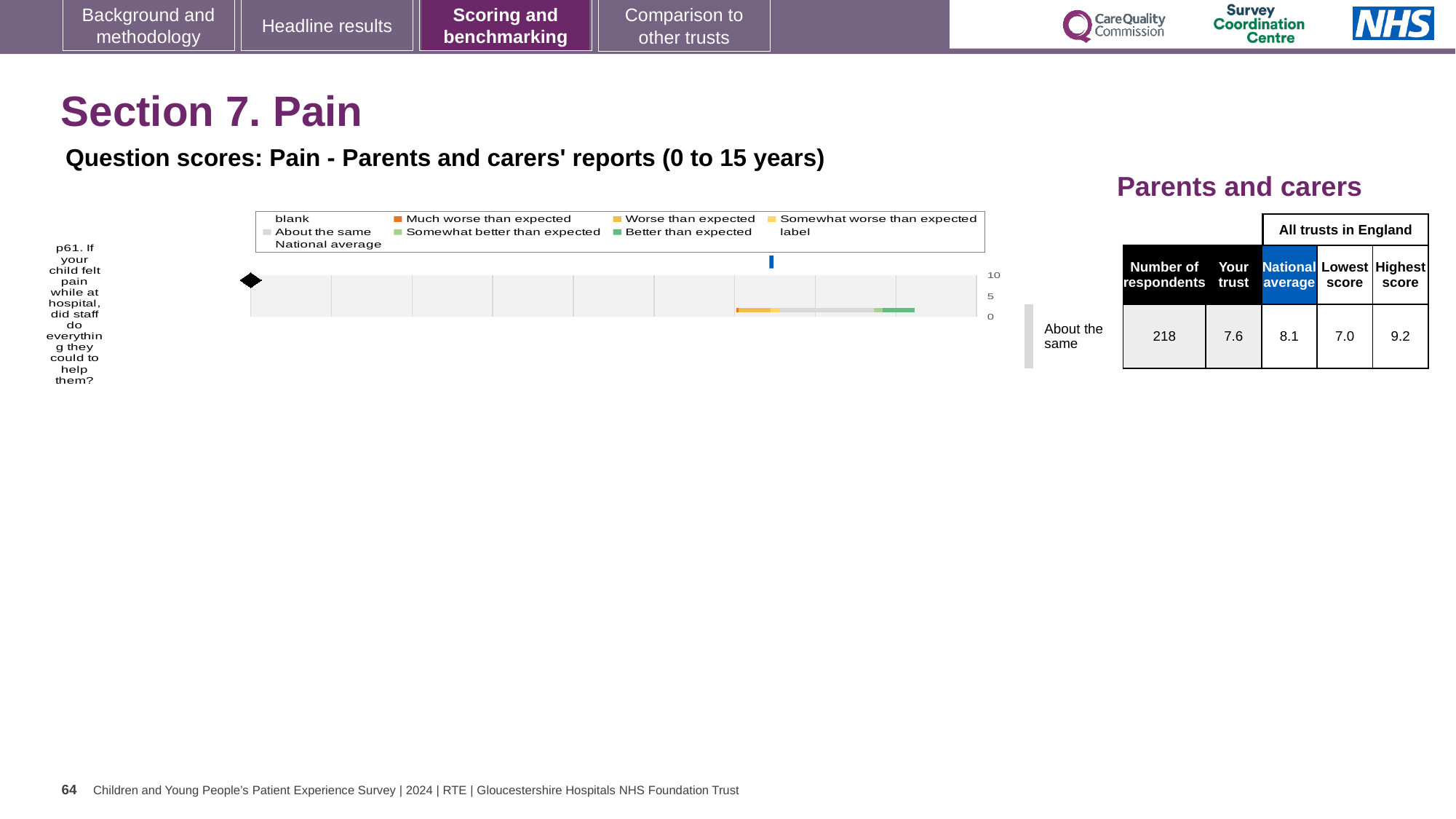
How many respondents answered question p61? 218 What benchmark category is given for question p61? About the same Which is larger for question p61: the 'Your trust' score or the national average? National average What kind of chart is shown on the slide? bar chart What is the highest value shown on the chart's axis? 10 What is the difference between the highest and lowest scores for question p61? 2.2 How many survey questions are plotted in the chart? 1 What is the 'Your trust' score for question p61 in the table? 7.6 What colour does the legend use for 'Better than expected'? green What is the national average score for question p61? 8.1 What is the highest score among all trusts in England for question p61? 9.2 What is the lowest score among all trusts in England for question p61? 7.0